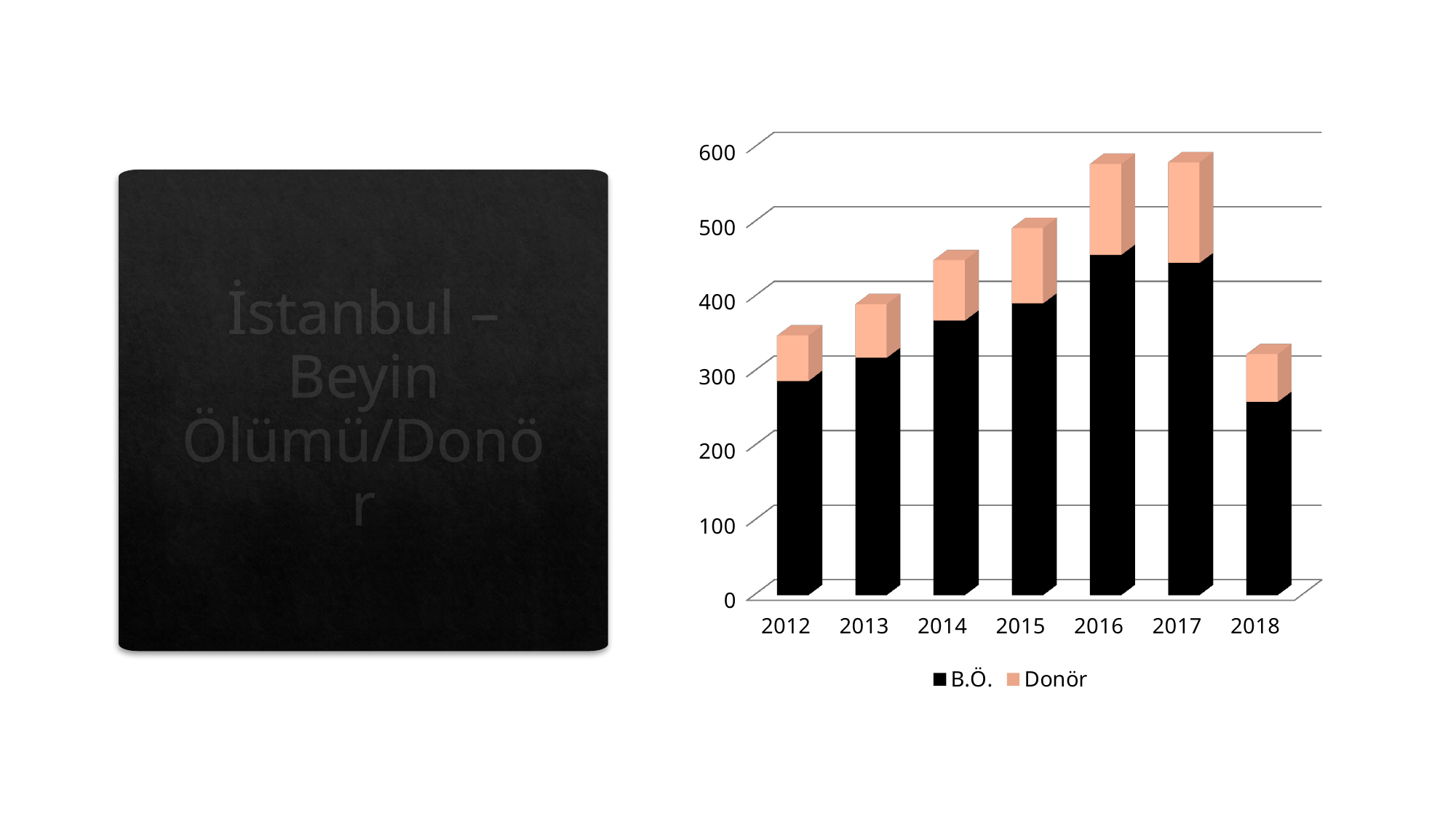
Do the total stacked bar values rise or fall from 2012 to 2016? rise What kind of chart is shown on the slide? stacked bar chart Which year has the lowest B.Ö. value? 2018 Is the B.Ö. value for 2012 greater or less than 400? less Which colour represents the Donör series in the chart? orange (peach) Is the B.Ö. value for 2018 greater or less than 300? less What are the two series named in the chart legend? B.Ö. and Donör Is the B.Ö. value for 2016 greater or less than 400? greater How many years are shown on the x axis of the chart? 7 How many series does the chart legend list? 2 Which year has the lowest total stacked bar? 2018 Which year has the larger B.Ö. value, 2013 or 2015? 2015